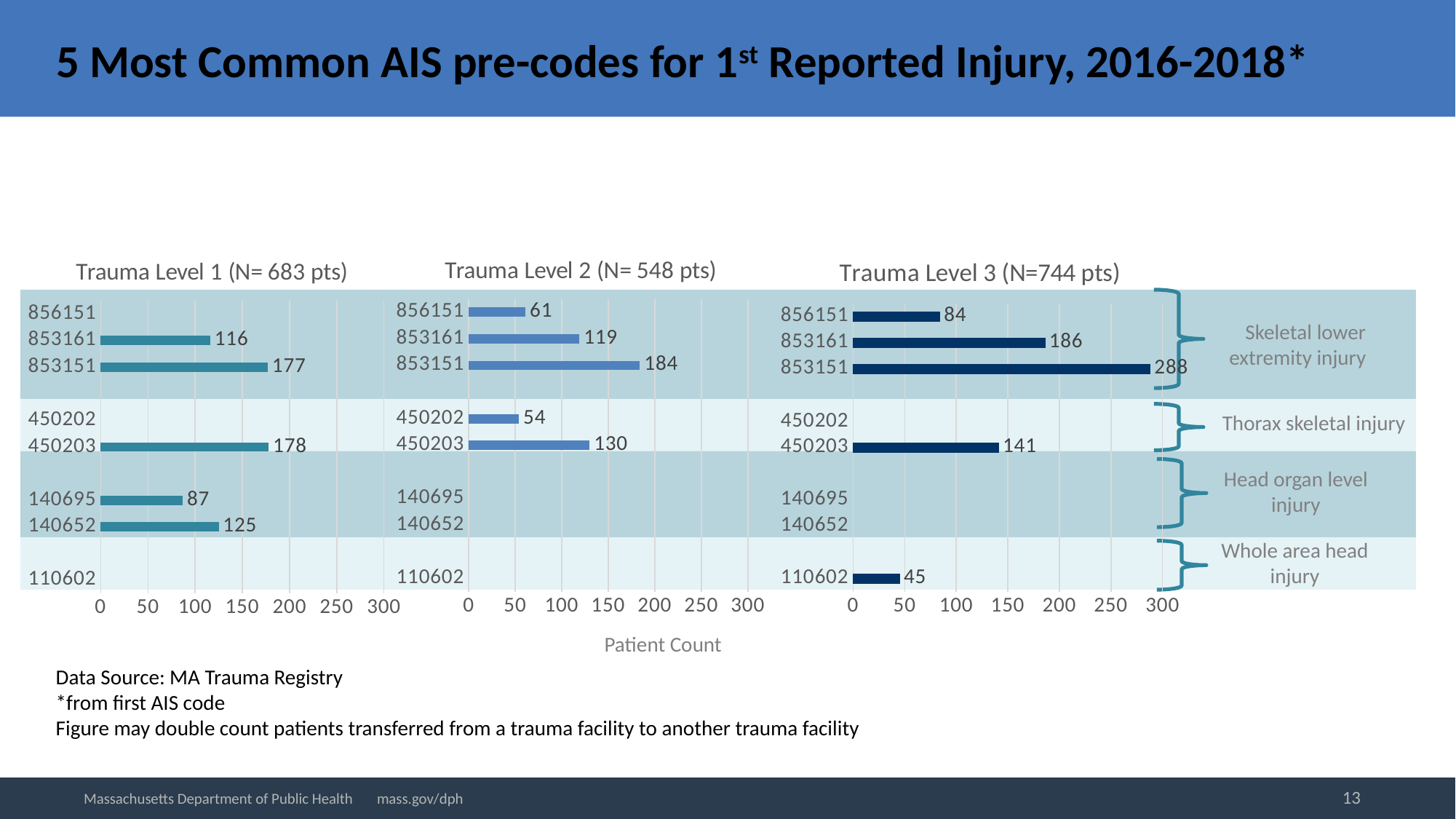
In the Trauma Level 2 chart, what is the patient count for code 450203? 130 In the Trauma Level 1 chart, which has a larger patient count, code 140652 or code 140695? 140652 In the Trauma Level 2 chart, is the value for code 853151 greater or less than 150? greater What type of chart is used for the Trauma Level 1 data? Bar chart What is the x-axis label shared by the three charts? Patient Count In the Trauma Level 1 chart, what is the patient count for code 853151? 177 In the Trauma Level 3 chart, which code has the highest patient count? 853151 In the Trauma Level 3 chart, which code has the lowest patient count among the plotted bars? 110602 According to the chart title, how many patients are in the Trauma Level 3 group? 744 pts In the Trauma Level 3 chart, what is the difference in patient count between code 853151 and code 853161? 102 In the Trauma Level 2 chart, which code has the highest patient count? 853151 In the Trauma Level 3 chart, what is the patient count for code 110602? 45